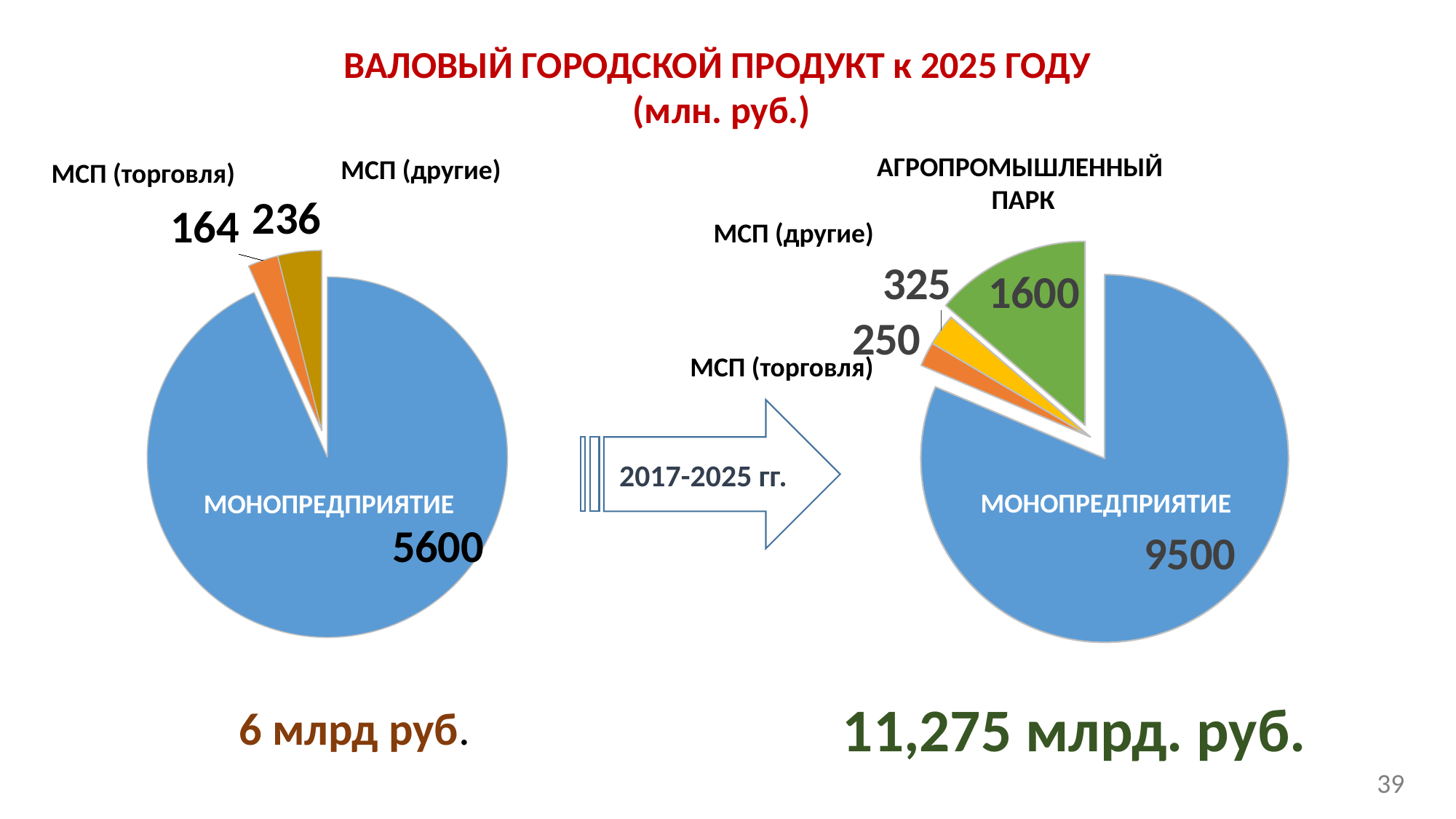
In the left pie chart, what is the value for МОНОПРЕДПРИЯТИЕ? 5600 In the left pie chart, what is the value for МСП (другие)? 236 In the right pie chart, what is the difference between МСП (другие) and МСП (торговля)? 75 In the right pie chart, what is the value for АГРОПРОМЫШЛЕННЫЙ ПАРК? 1600 How many slices does the right pie chart have? 4 In the right pie chart, which category has the smallest value? МСП (торговля) What type of chart is used on the left side of the slide? Pie chart In the left pie chart, what is the value for МСП (торговля)? 164 In the right pie chart, what is the value for МСП (торговля)? 250 In the right pie chart, what is the value for МОНОПРЕДПРИЯТИЕ? 9500 In the left pie chart, which category has the largest value? МОНОПРЕДПРИЯТИЕ In the left pie chart, which is larger: МСП (торговля) or МСП (другие)? МСП (другие)